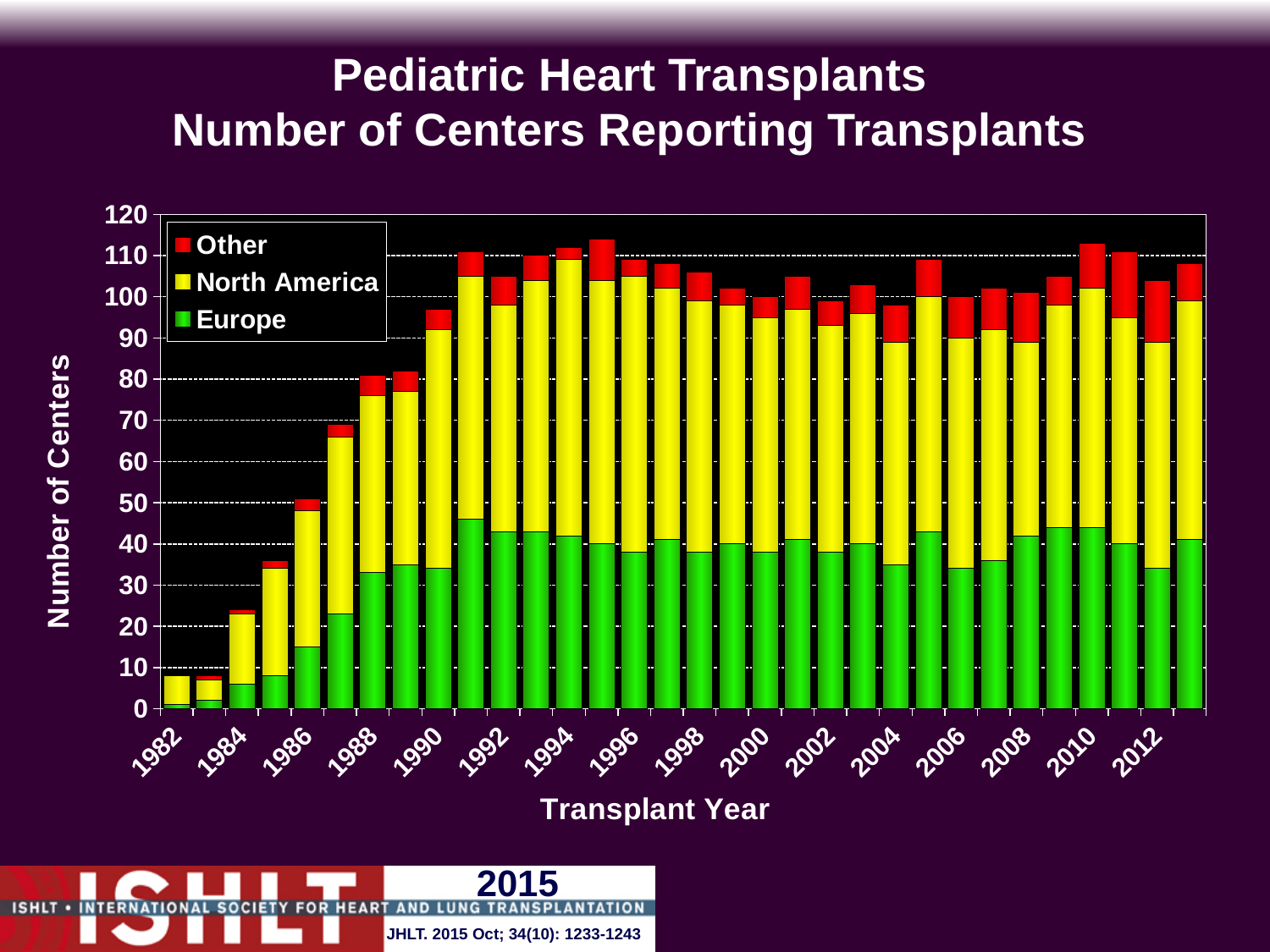
Is the total number of centers for 1995 greater or less than 110? greater How many transplant years (bars) are plotted in the chart? 32 Is the total number of centers for 1990 greater or less than 90? greater Is the total number of centers for 1991 greater or less than 100? greater What kind of chart is shown on the slide? Stacked bar chart What is the title of the x axis? Transplant Year Which series is larger in 1995, North America or Europe? North America Do the total numbers of centers rise or fall from 1982 to 1991? rise How many series does the legend list? 3 Which series are listed in the legend? Other, North America, Europe